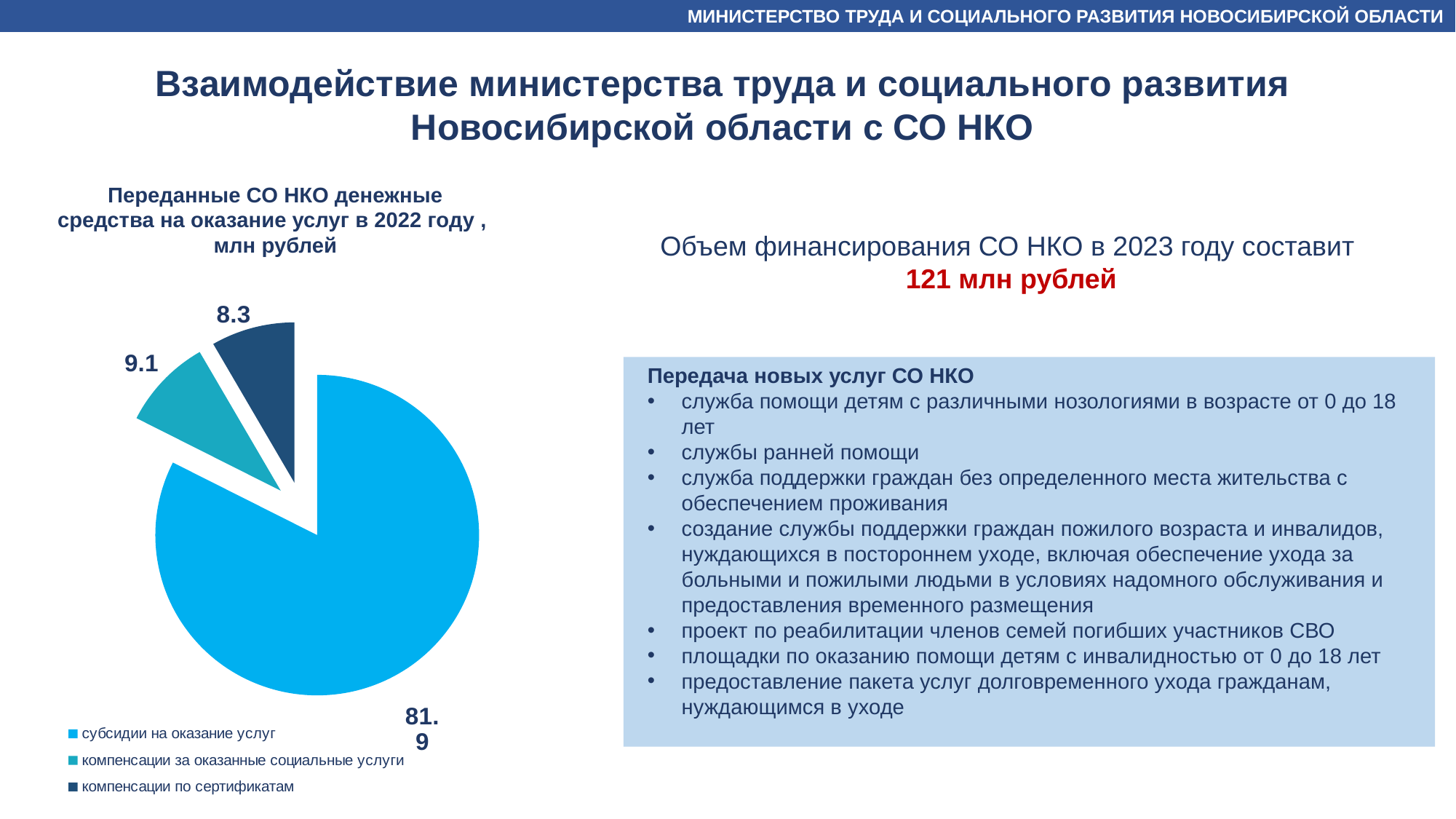
How many slices does the pie chart have? 3 What is the value for субсидии на оказание услуг in the pie chart? 81.9 Which category has the largest slice in the pie chart? субсидии на оказание услуг What is the total of all slices in the pie chart? 99.3 What is the difference between компенсации за оказанные социальные услуги and компенсации по сертификатам? 0.8 What is the title of the pie chart? Переданные СО НКО денежные средства на оказание услуг в 2022 году, млн рублей What is the difference between субсидии на оказание услуг and компенсации за оказанные социальные услуги? 72.8 Which is larger: компенсации за оказанные социальные услуги or компенсации по сертификатам? компенсации за оказанные социальные услуги What is the value for компенсации за оказанные социальные услуги? 9.1 What type of chart is shown on the slide? pie chart Which category has the smallest slice in the pie chart? компенсации по сертификатам What is the value for компенсации по сертификатам? 8.3